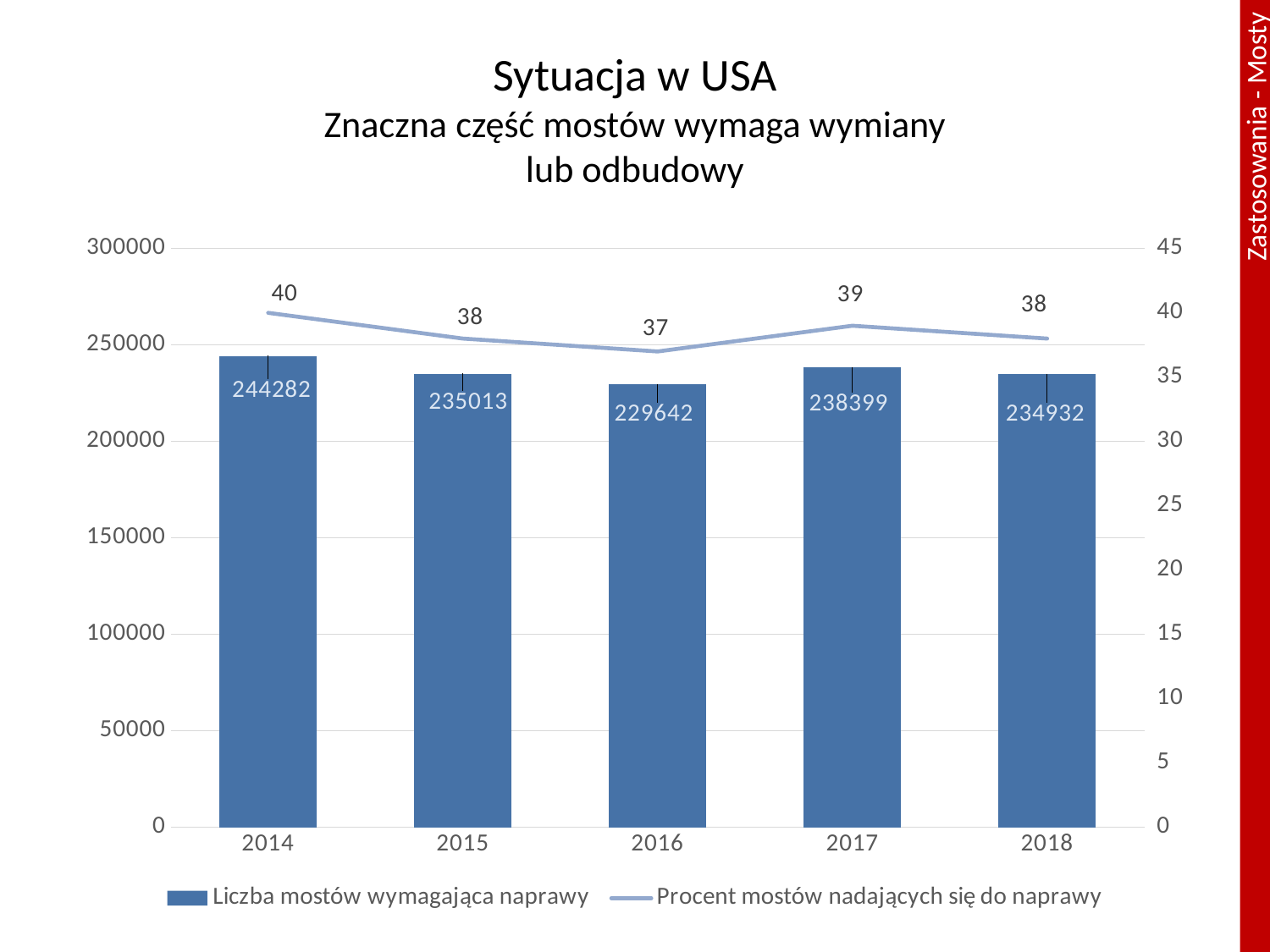
What is the difference between the 'Liczba mostów wymagająca naprawy' values for 2014 and 2016? 14640 Is the value for 'Liczba mostów wymagająca naprawy' in 2015 greater or less than 250000? less Which year has the highest value for 'Liczba mostów wymagająca naprawy'? 2014 Which is larger: the 'Liczba mostów wymagająca naprawy' value for 2017 or for 2018? 2017 How many years are shown on the x axis? 5 What is the title of the slide? Sytuacja w USA What is the value of 'Procent mostów nadających się do naprawy' for 2017? 39 What kinds of chart are combined on this slide? Bar chart and line chart Which year has the lowest value for 'Procent mostów nadających się do naprawy'? 2016 What is the value of 'Liczba mostów wymagająca naprawy' for 2014? 244282 How many series does the legend list? 2 What is the value of 'Liczba mostów wymagająca naprawy' for 2016? 229642